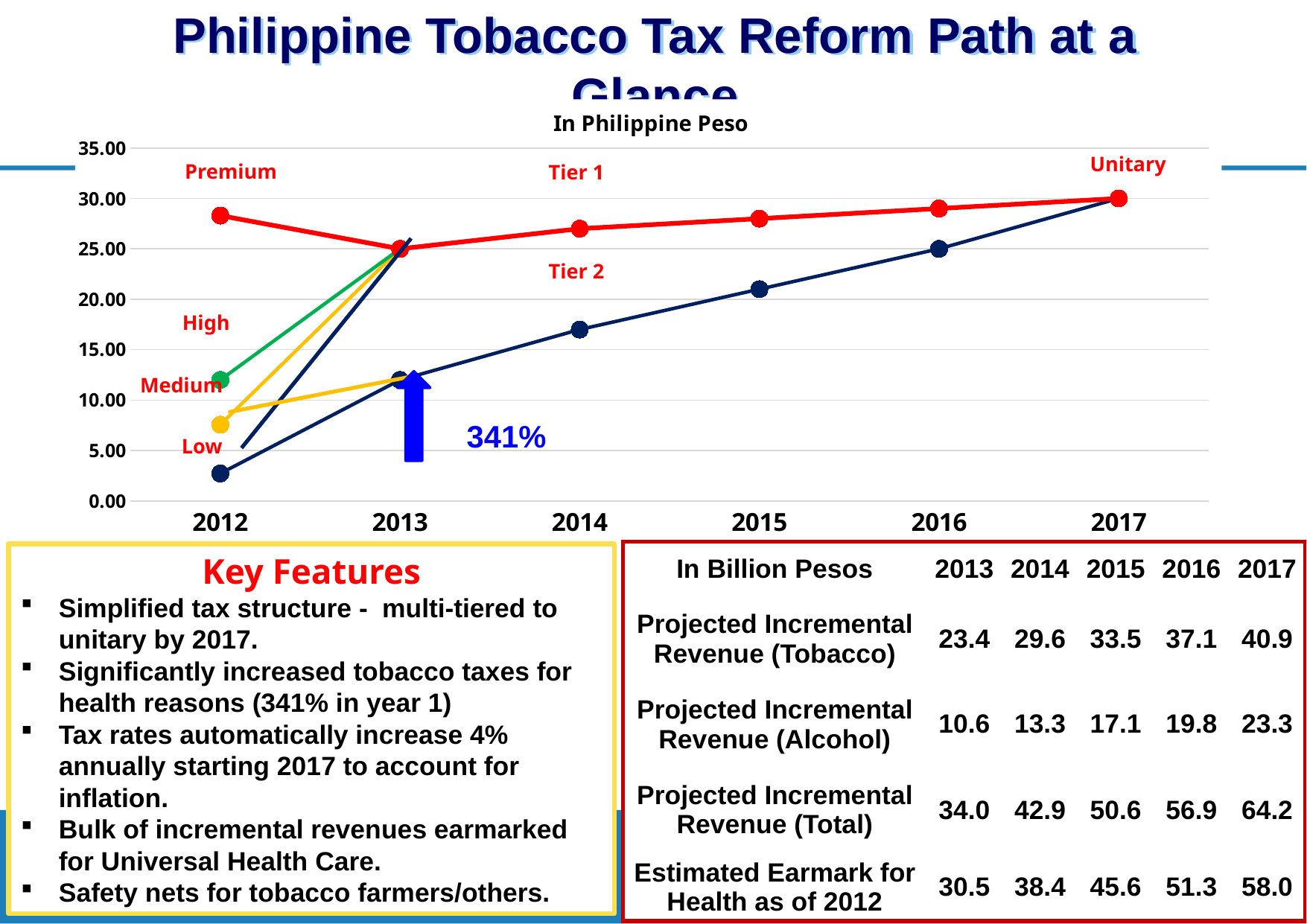
Is the Medium value in 2012 greater or less than 10.00? less Is the Low value in 2012 greater or less than 5.00? less Which of the 2012 categories has the lowest value: Premium, High, Medium or Low? Low Is the Tier 2 value in 2014 greater or less than 15.00? greater What is the title of the chart? In Philippine Peso Does the Tier 2 line rise or fall from 2013 to 2017? rise What kind of chart is shown on the slide? line chart What percentage increase is annotated next to the blue arrow at 2013? 341% Which is larger in 2014, the Tier 1 value or the Tier 2 value? Tier 1 How many years are shown along the x axis of the chart? 6